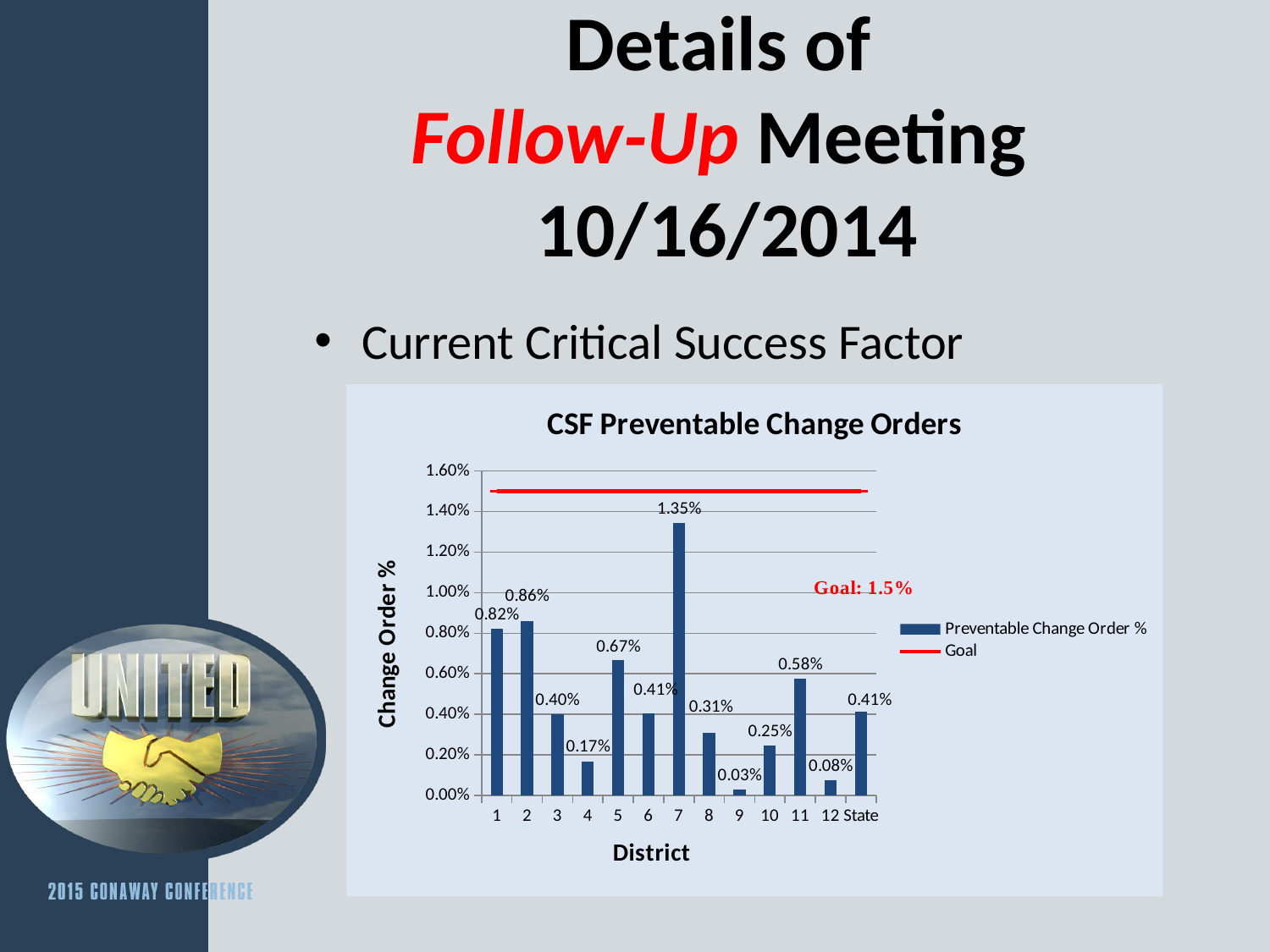
What is the goal value shown on the chart? 1.5% What is the Preventable Change Order % for District 7? 1.35% How many series does the chart legend list? 2 What is the Preventable Change Order % for District 11? 0.58% Which district has the highest Preventable Change Order %? 7 What is the title of the chart? CSF Preventable Change Orders Which district has the lowest Preventable Change Order %? 9 What is the Preventable Change Order % for the State? 0.41% How many categories are shown on the x axis of the chart? 13 Which has a higher Preventable Change Order %, District 5 or District 11? District 5 What type of chart is shown on the slide? Combination bar and line chart What is the difference between the Preventable Change Order % of District 2 and District 1? 0.04%